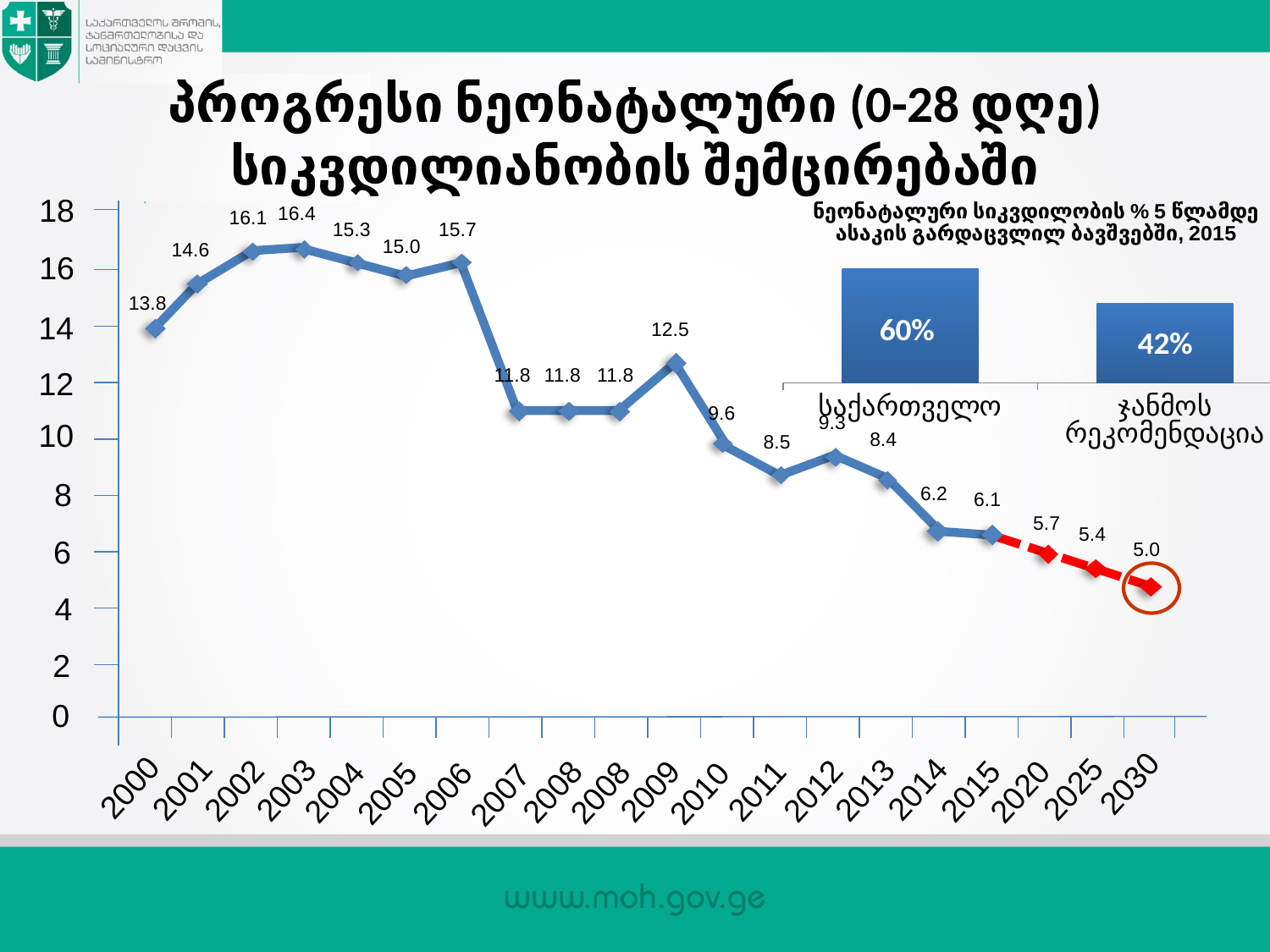
How many data points are plotted on the line chart? 20 On the line chart, what is the value for 2009? 12.5 On the line chart, do the values generally rise or fall from 2006 to 2030? fall On the line chart, what is the difference between the values for 2000 and 2015? 7.7 On the line chart, which is larger, the value for 2005 or the value for 2006? 2006 On the line chart, which year has the lowest value? 2030 On the bar chart in the upper right, what is the difference between საქართველო and ჯანმოს რეკომენდაცია? 18% On the line chart, what is the value for 2000? 13.8 On the line chart, what is the value for 2030? 5.0 What kind of chart is the small chart in the upper right of the slide? bar chart On the bar chart in the upper right, what is the value for საქართველო? 60% On the line chart, which year has the highest value? 2003